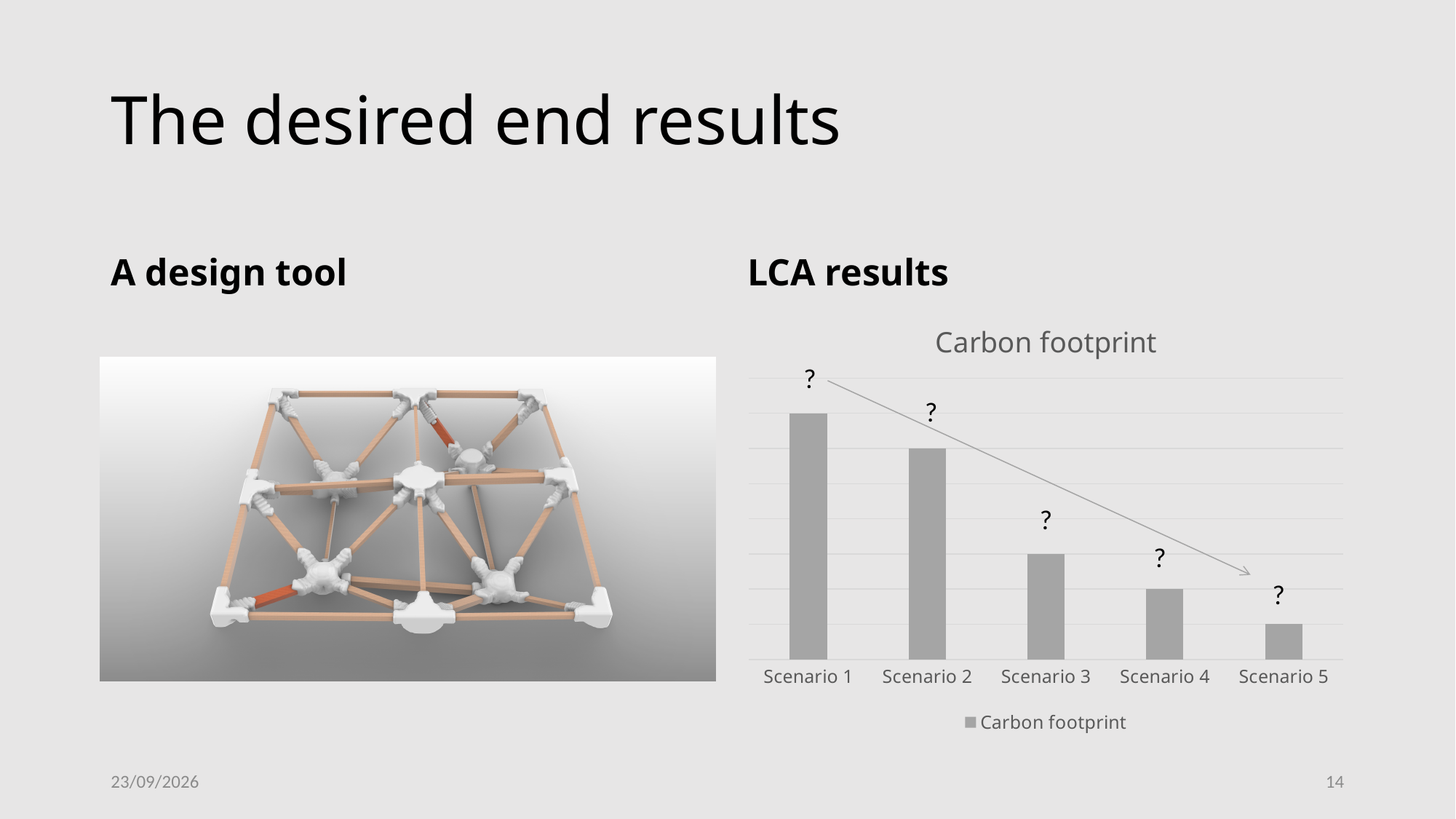
What symbol is shown as the data label above each bar in the Carbon footprint chart? ? Do the bars in the Carbon footprint chart rise or fall from Scenario 1 to Scenario 5? fall Which has the larger bar in the Carbon footprint chart, Scenario 3 or Scenario 5? Scenario 3 What kind of chart is shown under "LCA results"? bar chart Which scenario has the lowest bar in the Carbon footprint chart? Scenario 5 How many series does the legend of the Carbon footprint chart list? 1 Which scenario has the highest bar in the Carbon footprint chart? Scenario 1 Which has the larger bar in the Carbon footprint chart, Scenario 2 or Scenario 4? Scenario 2 What is the title of the chart? Carbon footprint How many scenarios are plotted in the Carbon footprint chart? 5 What is the legend entry of the Carbon footprint chart? Carbon footprint